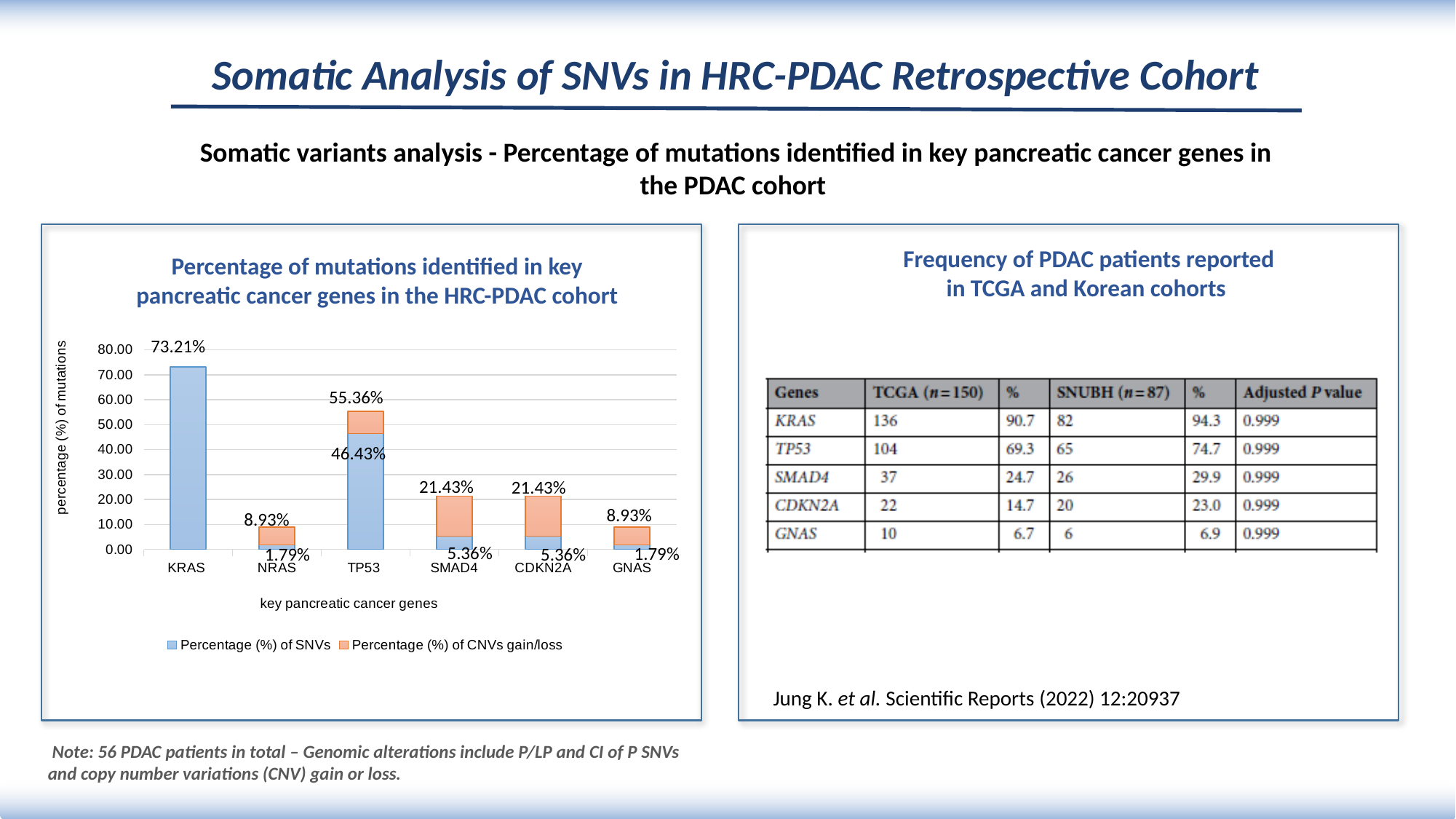
What is the difference between the Percentage (%) of SNVs for KRAS and for TP53 in the bar chart? 26.78% What kind of chart is shown on the left of the slide? bar chart What value is labelled at the top of the CDKN2A bar in the bar chart? 21.43% How many series does the legend of the bar chart list? 2 What is the title of the y axis of the bar chart? percentage (%) of mutations What value is labelled at the top of the TP53 bar in the bar chart? 55.36% Which has the larger Percentage (%) of SNVs in the bar chart, KRAS or TP53? KRAS Which gene has the highest Percentage (%) of SNVs in the bar chart? KRAS What is the Percentage (%) of SNVs for KRAS in the bar chart? 73.21% What is the Percentage (%) of SNVs for SMAD4 in the bar chart? 5.36% What is the Percentage (%) of SNVs for TP53 in the bar chart? 46.43% How many genes are shown on the x axis of the bar chart? 6